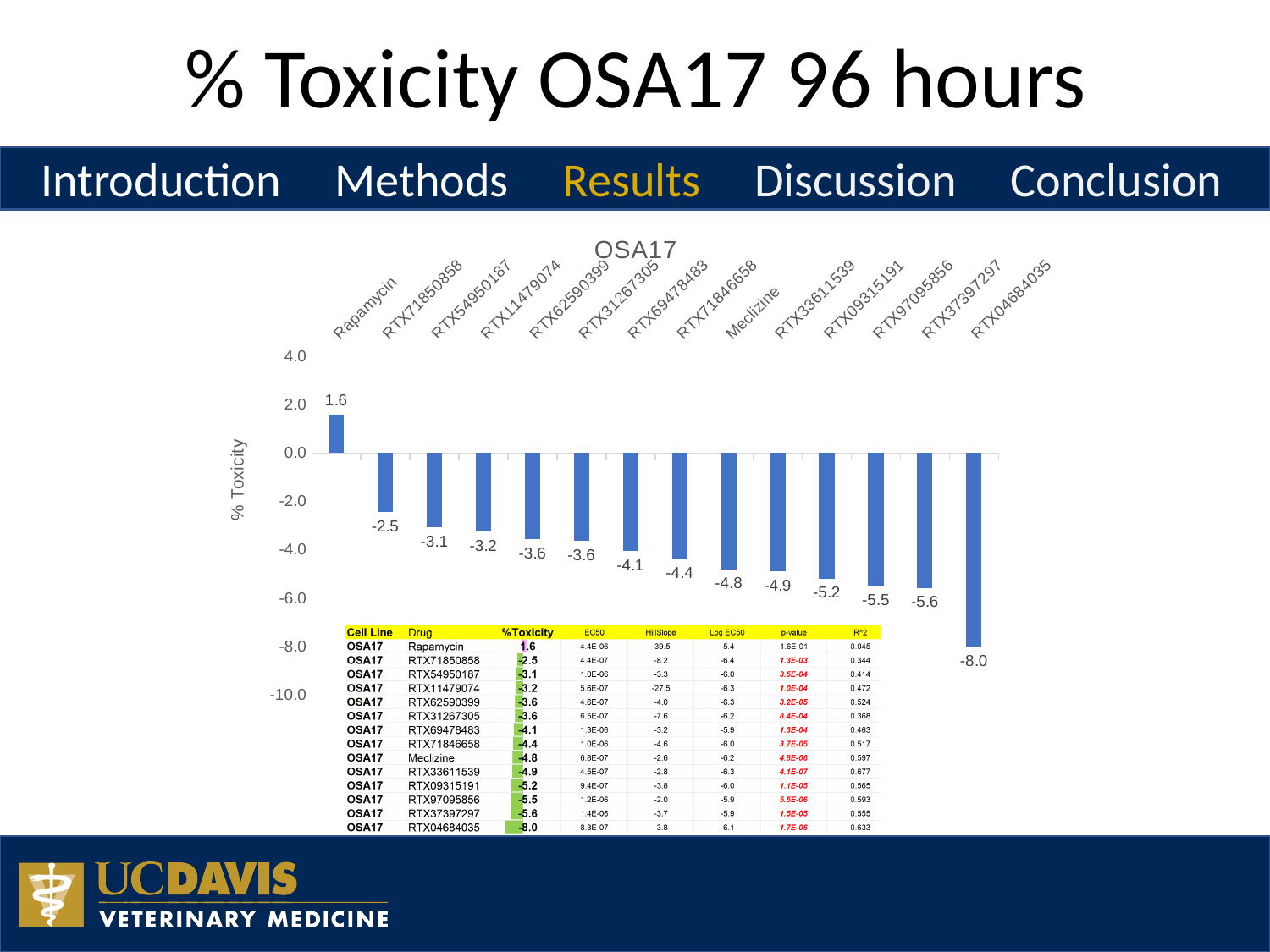
What kind of chart is shown on the slide? bar chart What is the % Toxicity value for Meclizine? -4.8 Which has a larger % Toxicity value, RTX54950187 or RTX37397297? RTX54950187 What is the % Toxicity value for Rapamycin? 1.6 What is the % Toxicity value for RTX04684035? -8.0 Which drug has the lowest % Toxicity value in the chart? RTX04684035 Which drug has the highest % Toxicity value in the chart? Rapamycin What is the title of the chart? OSA17 What is the % Toxicity value for RTX71850858? -2.5 Do the % Toxicity values generally rise or fall moving from left to right along the x axis? fall What is the difference between the % Toxicity values for Rapamycin and RTX04684035? 9.6 How many drugs are plotted in the chart? 14